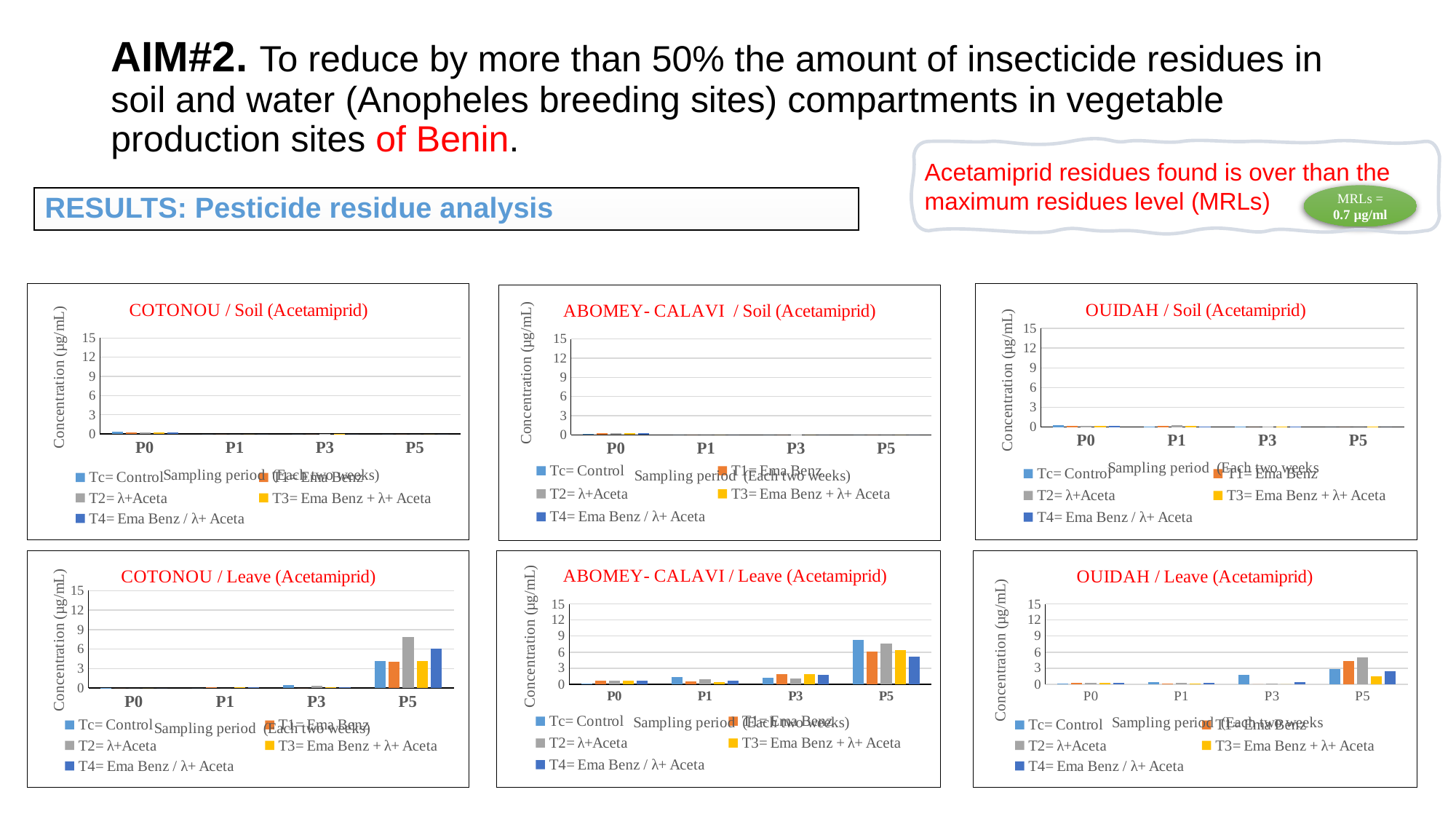
In the ABOMEY-CALAVI / Leave (Acetamiprid) chart, is the value for Tc= Control at P5 greater or less than 6? greater In the COTONOU / Leave (Acetamiprid) chart, is the value for T2= λ+Aceta at P5 greater or less than 6? greater What kind of chart is the COTONOU / Soil (Acetamiprid) chart? bar chart In the ABOMEY-CALAVI / Leave (Acetamiprid) chart, do the Tc= Control values rise or fall from P0 to P5? rise In the COTONOU / Leave (Acetamiprid) chart, which sampling period has the highest concentrations? P5 In the OUIDAH / Leave (Acetamiprid) chart, is the value for T2= λ+Aceta at P5 greater or less than 3? greater In the COTONOU / Leave (Acetamiprid) chart, which treatment has the highest bar at P5? T2= λ+Aceta In the COTONOU / Leave (Acetamiprid) chart at P5, which is larger: T2= λ+Aceta or T4= Ema Benz / λ+ Aceta? T2= λ+Aceta How many sampling periods are shown on the x axis of the ABOMEY-CALAVI / Soil (Acetamiprid) chart? 4 How many series does the legend of the COTONOU / Leave (Acetamiprid) chart list? 5 What is the y-axis label of the OUIDAH / Leave (Acetamiprid) chart? Concentration (µg/mL)